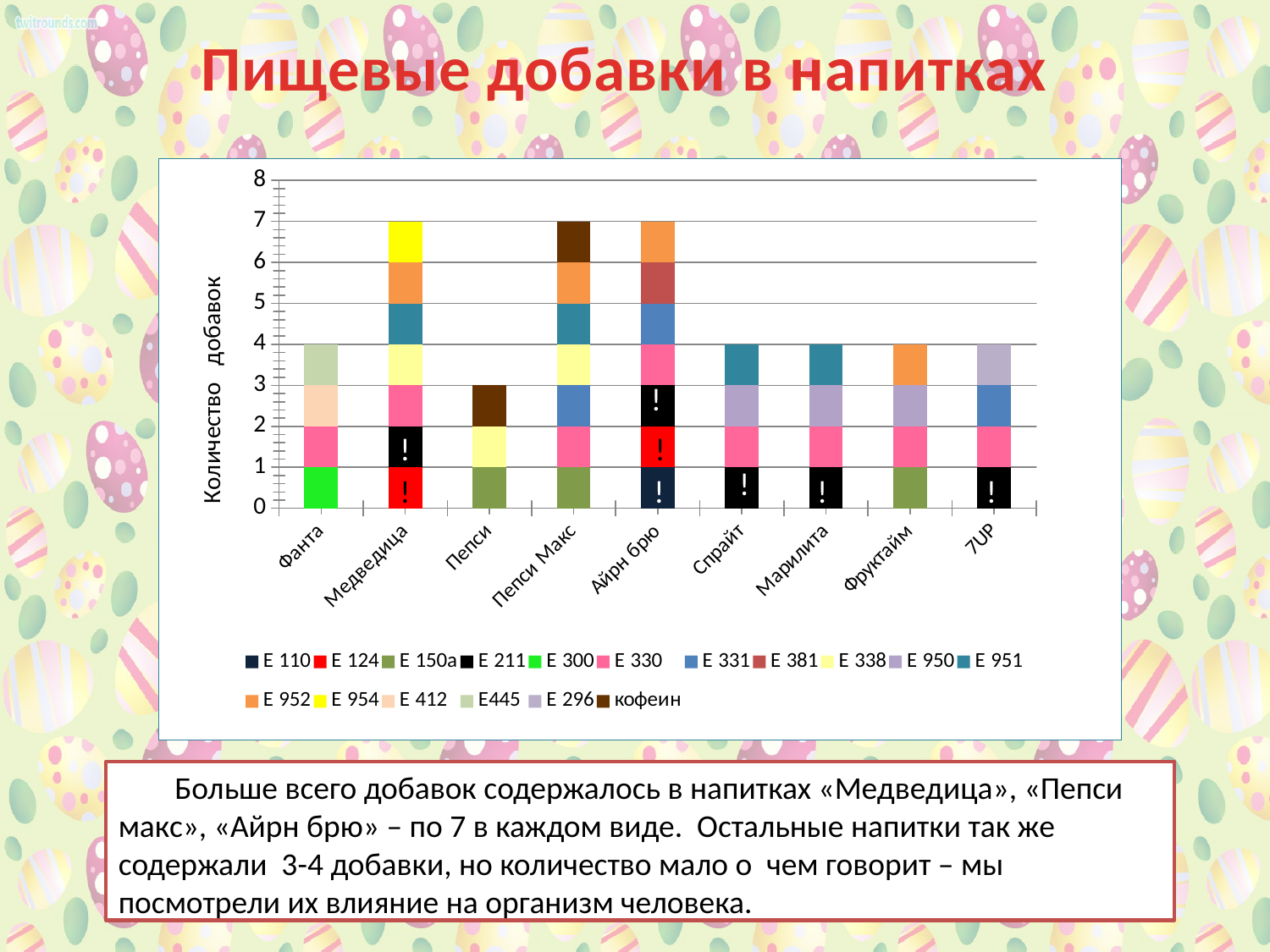
What is the label on the vertical axis of the chart? Количество добавок Which drinks have the highest total number of additives? Медведица, Пепси Макс, Айрн брю How many drinks (categories) are shown on the x axis of the chart? 9 What kind of chart is shown on the slide? Stacked bar chart What is the total number of additives shown for Айрн брю? 7 How many series does the chart legend list? 17 Which drink has the lowest total number of additives? Пепси What is the difference between the total for Медведица and the total for Пепси? 4 What is the total number of additives shown for Фанта? 4 Which has a larger total, Фанта or Пепси? Фанта What is the total number of additives shown for Пепси? 3